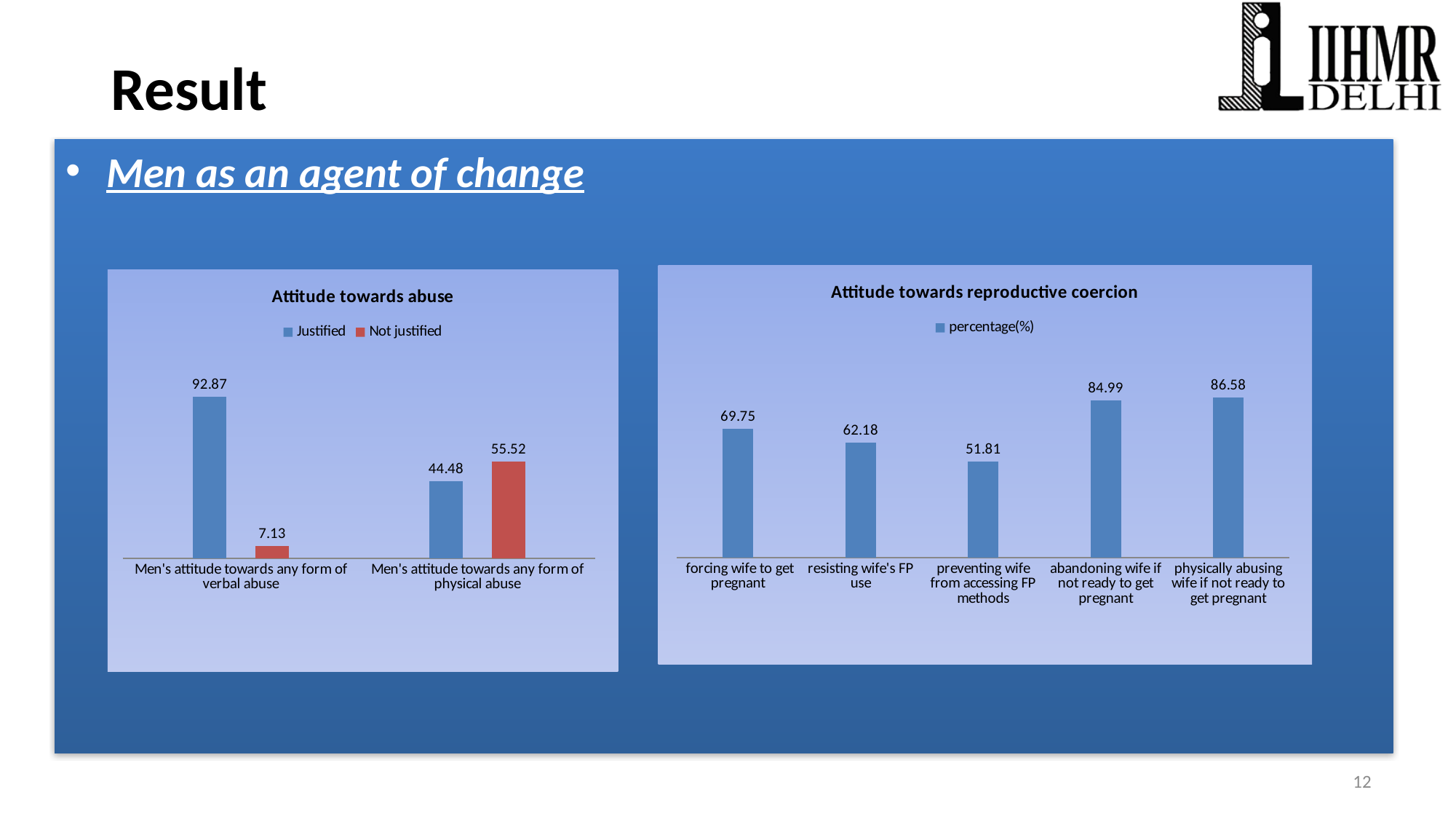
In the 'Attitude towards abuse' chart, what is the difference between the Justified and Not justified values for verbal abuse? 85.74 What kind of chart is the 'Attitude towards abuse' chart? Bar chart What is the legend entry in the 'Attitude towards reproductive coercion' chart? percentage(%) In the 'Attitude towards reproductive coercion' chart, which category has the lowest value? preventing wife from accessing FP methods In the 'Attitude towards abuse' chart, which is larger for physical abuse: Justified or Not justified? Not justified How many series does the legend of the 'Attitude towards abuse' chart list? 2 In the 'Attitude towards abuse' chart, what is the Not justified value for men's attitude towards any form of physical abuse? 55.52 How many categories are shown in the 'Attitude towards reproductive coercion' chart? 5 In the 'Attitude towards reproductive coercion' chart, what is the percentage for preventing wife from accessing FP methods? 51.81 In the 'Attitude towards reproductive coercion' chart, which category has the highest value? physically abusing wife if not ready to get pregnant In the 'Attitude towards reproductive coercion' chart, what is the difference between the values for forcing wife to get pregnant and resisting wife's FP use? 7.57 In the 'Attitude towards abuse' chart, what is the Justified value for men's attitude towards any form of verbal abuse? 92.87